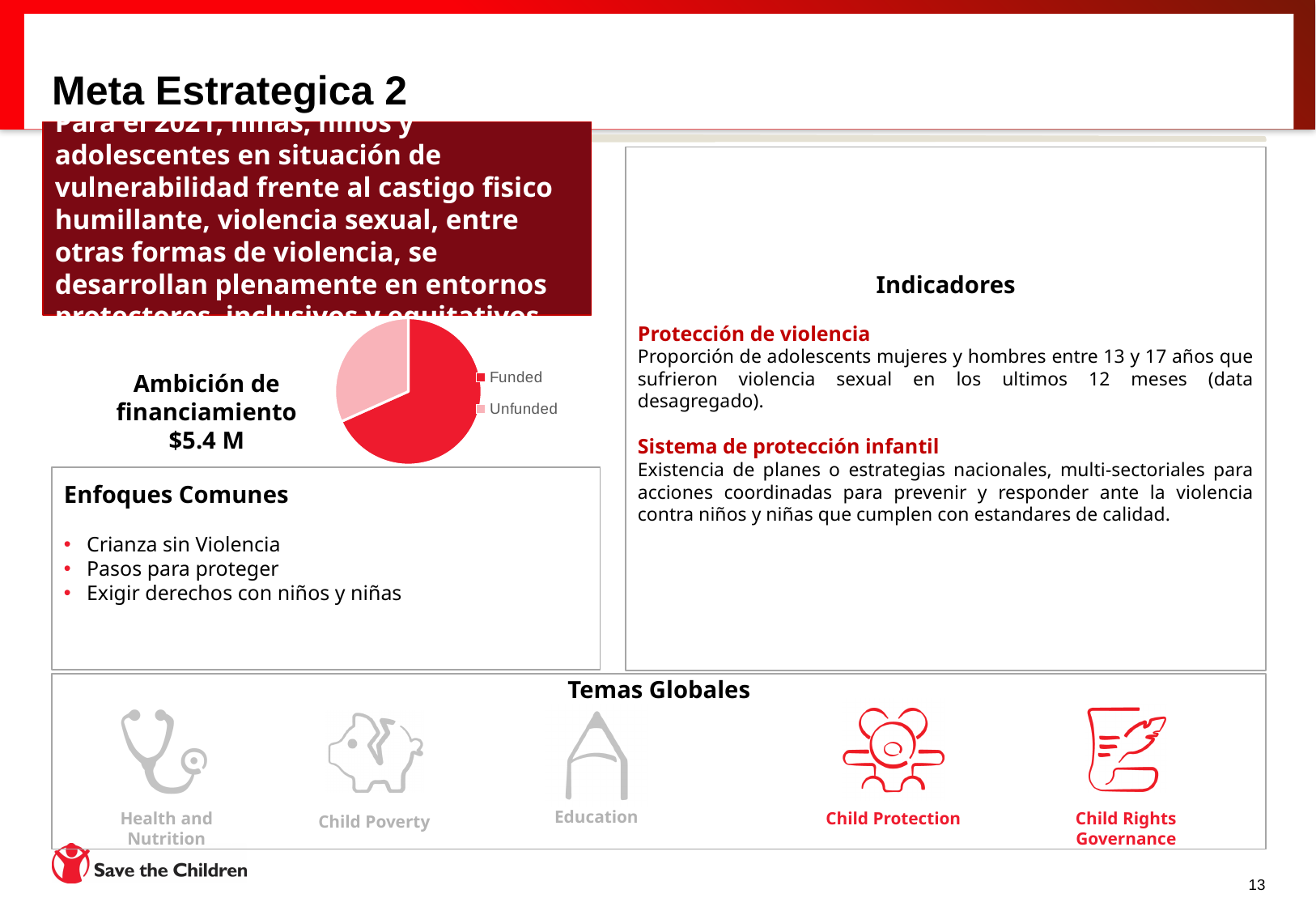
How many entries does the pie chart's legend list? 2 Which slice of the pie chart is the largest? Funded How many slices does the pie chart have? 2 What are the two legend entries of the pie chart? Funded and Unfunded Which slice of the pie chart is the smallest? Unfunded In the pie chart, which is larger, the Funded slice or the Unfunded slice? Funded What kind of chart is shown on the slide? pie chart Which legend entry of the pie chart is shown in the lighter pink colour? Unfunded